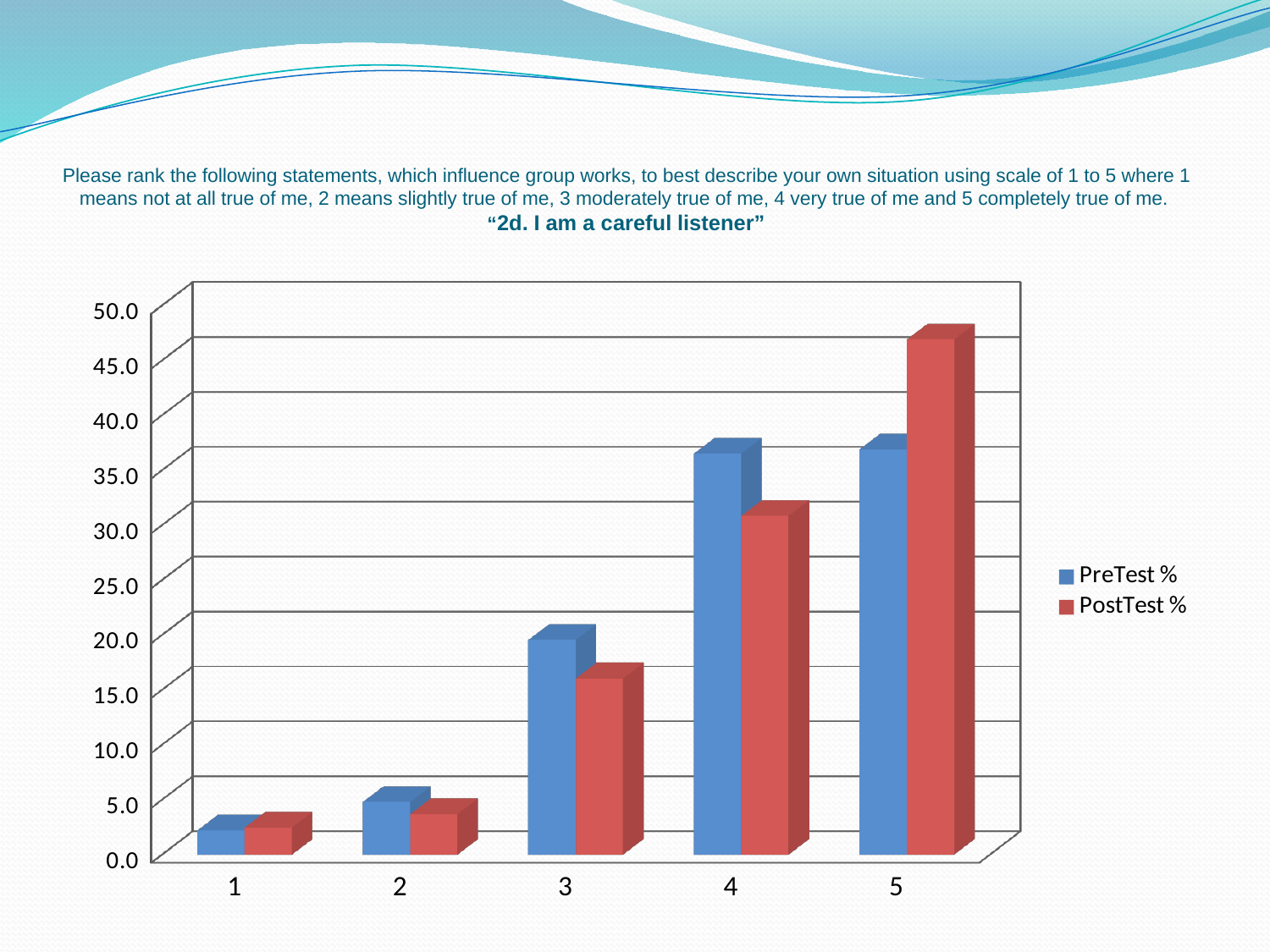
What are the two legend entries of the chart? PreTest % and PostTest % Do the PostTest % values rise or fall as the categories go from 1 to 5? rise Which category has the lowest PostTest % value? 1 For category 5, which is larger: PreTest % or PostTest %? PostTest % Which category has the lowest PreTest % value? 1 Which category has the highest PostTest % value? 5 How many series does the legend list? 2 For category 4, which is larger: PreTest % or PostTest %? PreTest % Is the PostTest % value for category 5 greater or less than 45.0? greater How many categories are shown on the x axis? 5 What kind of chart is shown on the slide? bar chart